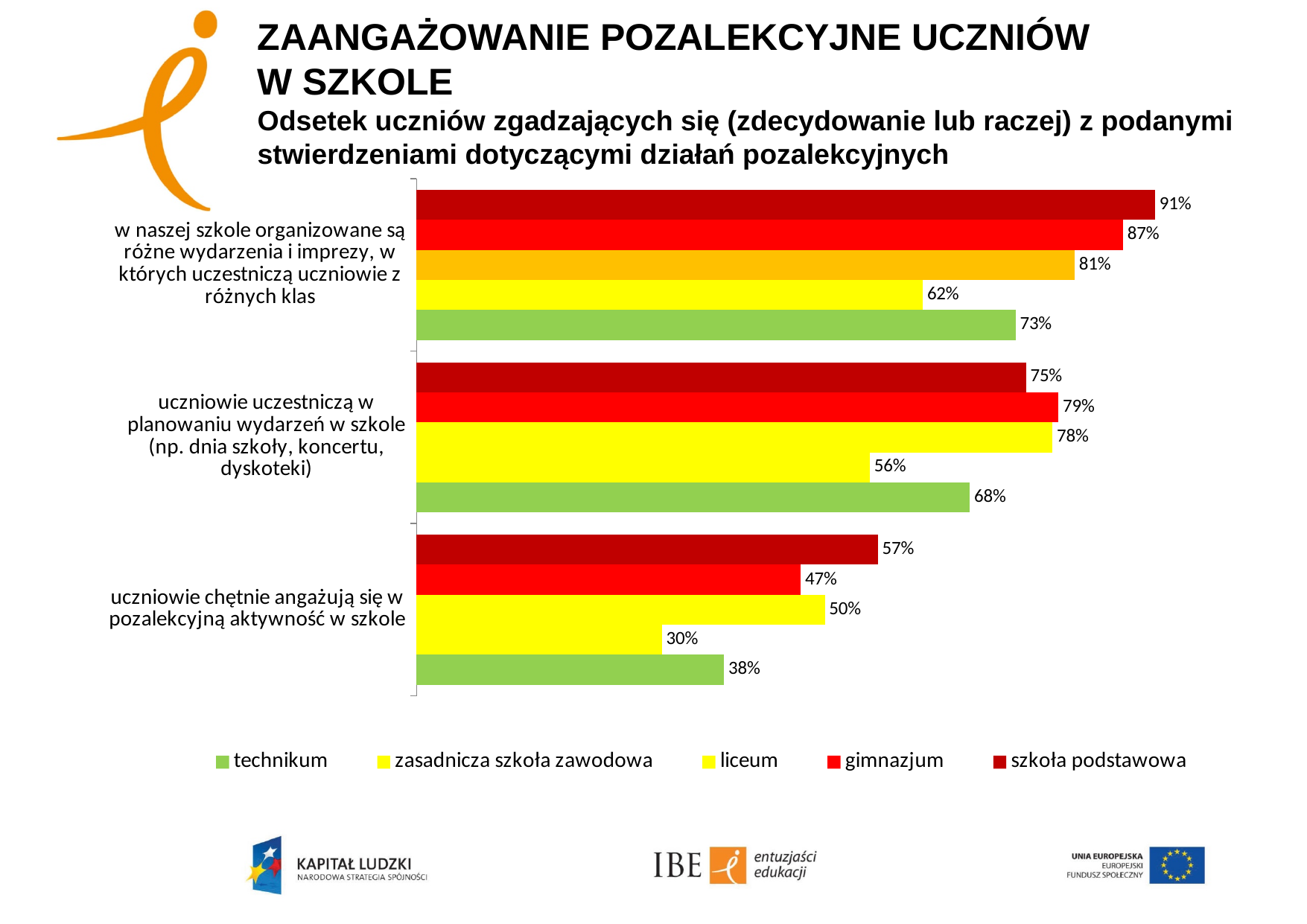
What is the value for szkoła podstawowa for the statement 'w naszej szkole organizowane są różne wydarzenia i imprezy, w których uczestniczą uczniowie z różnych klas'? 91% What is the value for technikum for the statement 'uczniowie chętnie angażują się w pozalekcyjną aktywność w szkole'? 38% How many statements (categories) are shown on the chart? 3 What is the difference between the szkoła podstawowa values for the first statement (91%) and the third statement (57%)? 34 percentage points What type of chart is shown on the slide? bar chart For technikum, which statement has the larger value: 'w naszej szkole organizowane są różne wydarzenia i imprezy' or 'uczniowie uczestniczą w planowaniu wydarzeń w szkole'? w naszej szkole organizowane są różne wydarzenia i imprezy What is the lowest value shown on the chart? 30% What is the difference between szkoła podstawowa and gimnazjum for the statement 'uczniowie chętnie angażują się w pozalekcyjną aktywność w szkole'? 10 percentage points What is the value for gimnazjum for the statement 'uczniowie uczestniczą w planowaniu wydarzeń w szkole'? 79% How many series does the legend list? 5 What colour represents technikum in the legend? green Which school type has the highest value for the statement 'w naszej szkole organizowane są różne wydarzenia i imprezy'? szkoła podstawowa